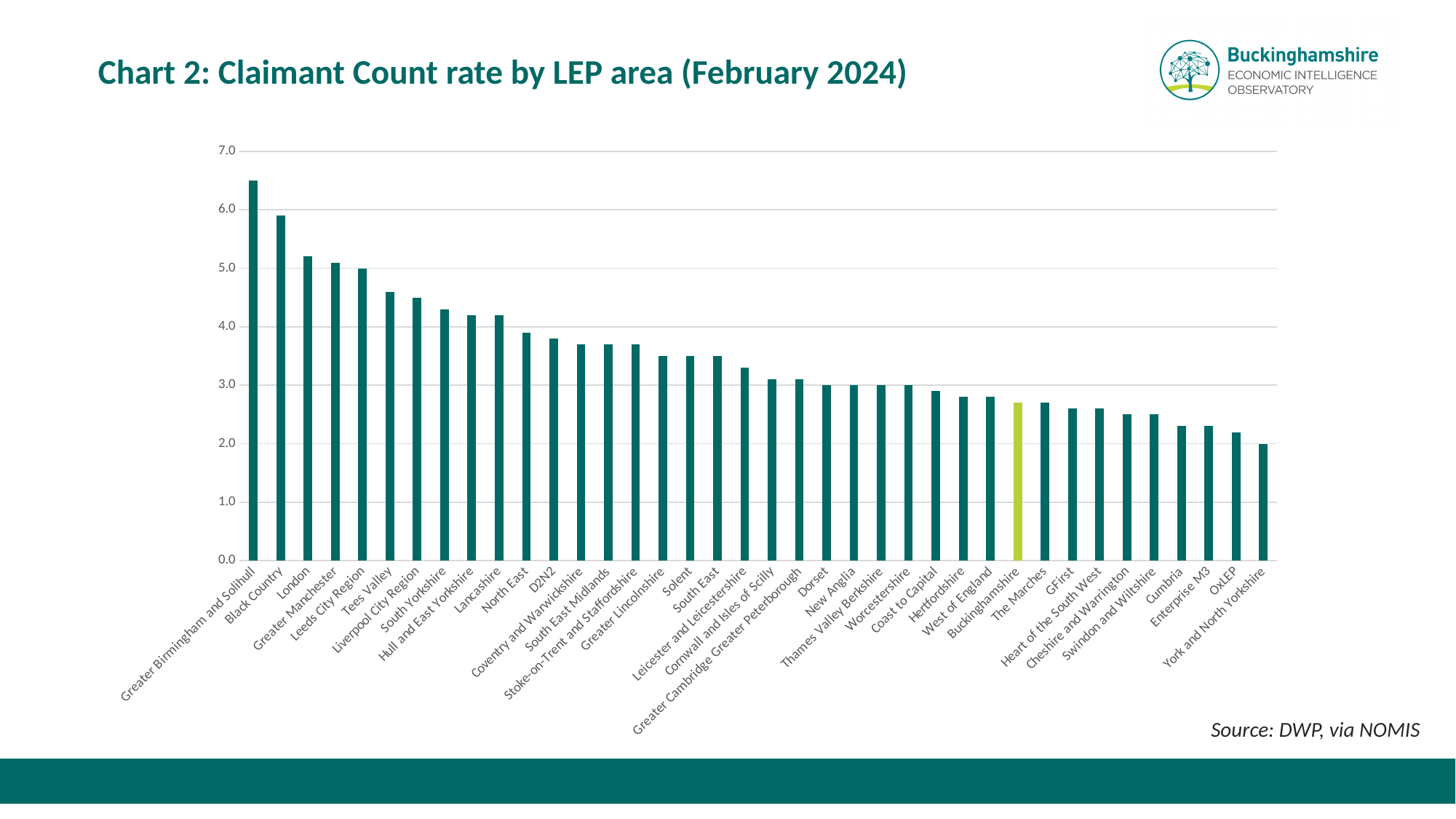
Which has the larger Claimant Count rate, London or Tees Valley? London How many LEP areas are plotted on the chart? 38 What is the source cited for the chart? DWP, via NOMIS What kind of chart is shown on the slide? Bar chart Do the values rise or fall moving from left to right along the x axis? Fall Which LEP area has the lowest Claimant Count rate? York and North Yorkshire Is the value for Buckinghamshire greater or less than 3.0? less Is the value for Black Country greater or less than 5.0? greater Is the value for Tees Valley greater or less than 5.0? less Which LEP area has the highest Claimant Count rate? Greater Birmingham and Solihull Which LEP area's bar is highlighted in a different (light green) colour? Buckinghamshire